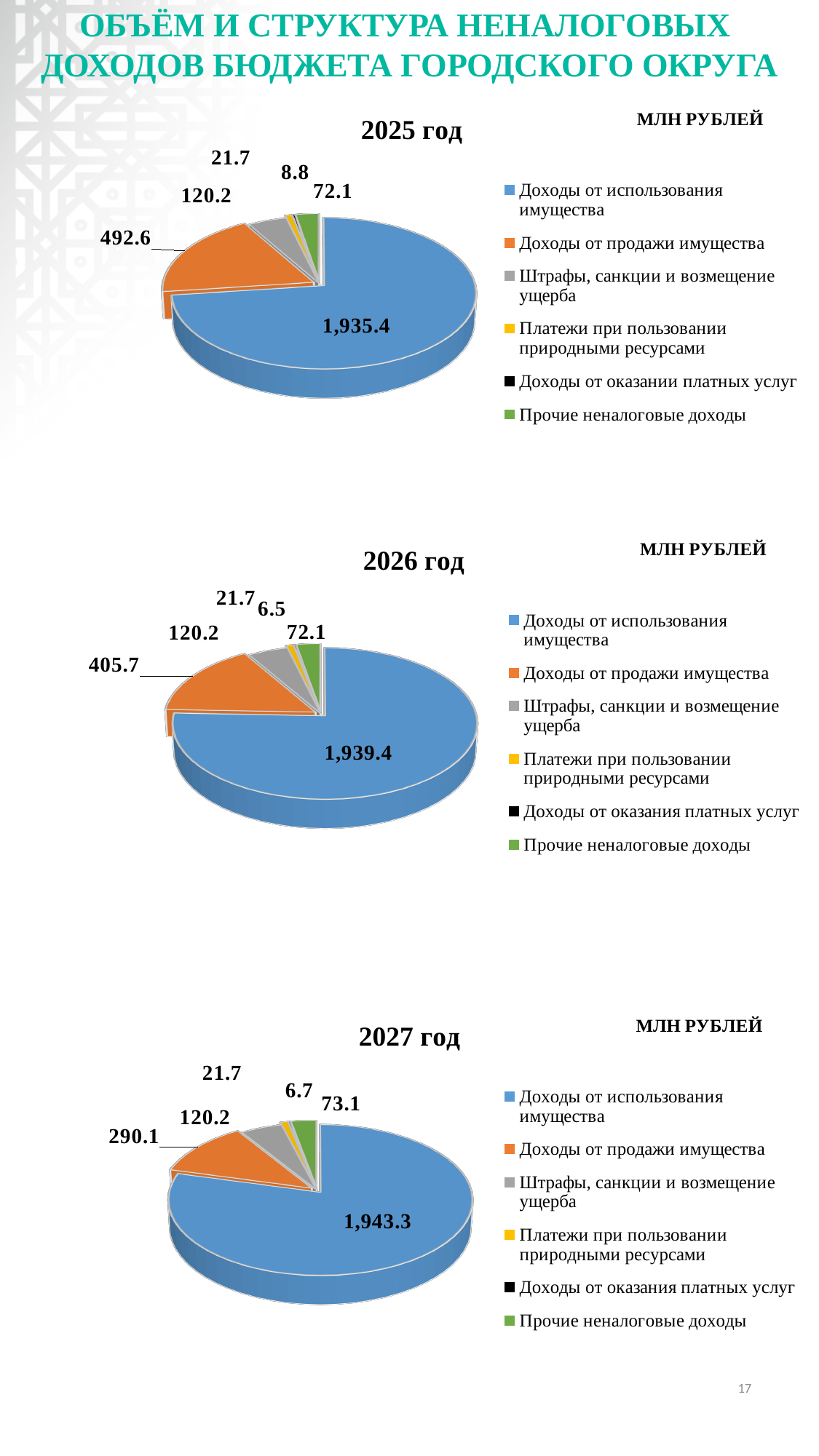
On the 2025 год pie chart, what is the value for Доходы от использования имущества? 1,935.4 On the 2025 год pie chart, what is the value for Доходы от продажи имущества? 492.6 What unit is stated above the legend of each chart? МЛН РУБЛЕЙ Which is larger: Доходы от использования имущества on the 2026 год chart or on the 2027 год chart? 2027 год (1,943.3) On the 2027 год pie chart, what is the value for Доходы от продажи имущества? 290.1 What kind of chart is used for 2027 год? Pie chart On the 2026 год pie chart, what is the value for Доходы от продажи имущества? 405.7 How many pie charts are shown on the slide? 3 What is the difference between the Доходы от продажи имущества values on the 2025 год and 2027 год pie charts? 202.5 On the 2027 год pie chart, what is the value for Доходы от использования имущества? 1,943.3 On the 2026 год pie chart, which category has the largest slice? Доходы от использования имущества How many entries does the legend of the 2025 год pie chart list? 6